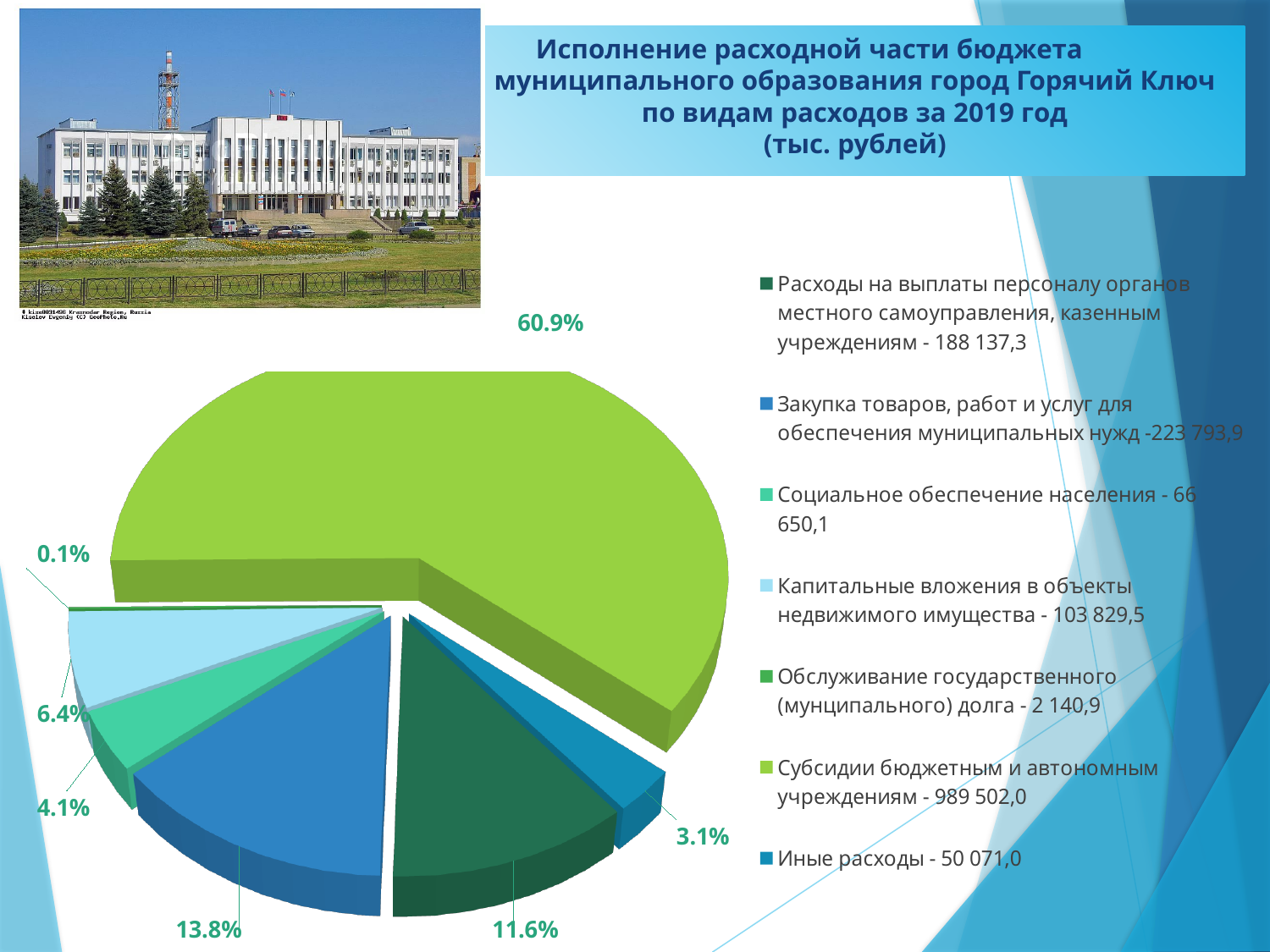
Which category has the largest share of the pie? Субсидии бюджетным и автономным учреждениям What is the difference in percentage points between the share for Субсидии бюджетным и автономным учреждениям (60.9%) and the share for Закупка товаров, работ и услуг (13.8%)? 47.1 percentage points What value (тыс. рублей) is listed in the legend for Капитальные вложения в объекты недвижимого имущества? 103 829,5 What type of chart is shown on the slide? pie chart Which has the larger share: Расходы на выплаты персоналу органов местного самоуправления, казенным учреждениям or Капитальные вложения в объекты недвижимого имущества? Расходы на выплаты персоналу органов местного самоуправления, казенным учреждениям What percentage share is shown for Иные расходы? 3.1% What value (тыс. рублей) is listed in the legend for Социальное обеспечение населения? 66 650,1 What percentage share is shown for Субсидии бюджетным и автономным учреждениям? 60.9% What year does the chart title say the budget expenditure data is for? 2019 How many categories (slices) does the pie chart have? 7 Which category has the smallest share of the pie? Обслуживание государственного (муниципального) долга What percentage share is shown for Закупка товаров, работ и услуг для обеспечения муниципальных нужд? 13.8%